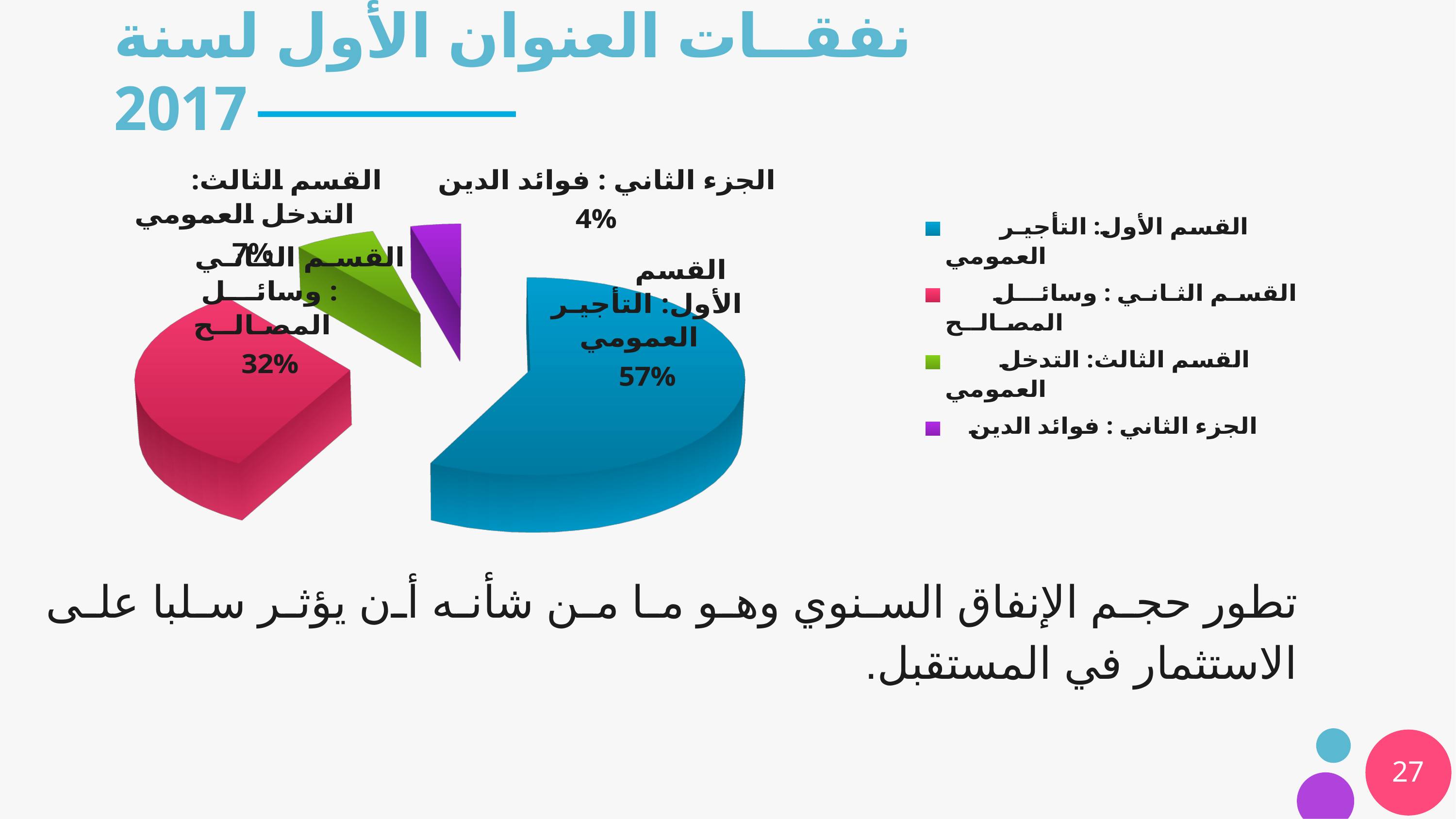
What share of the pie does القسم الثاني: وسائل المصالح represent? 32% Which category has the largest slice of the pie? القسم الأول: التأجير العمومي What kind of chart is shown on the slide? pie chart What share of the pie does القسم الثالث: التدخل العمومي represent? 7% Which is larger, the slice for القسم الثاني: وسائل المصالح or the slice for الجزء الثاني: فوائد الدين? القسم الثاني: وسائل المصالح How many slices does the pie chart have? 4 What share of the pie does القسم الأول: التأجير العمومي represent? 57% What colour is the slice for القسم الأول: التأجير العمومي? blue What share of the pie does الجزء الثاني: فوائد الدين represent? 4% How many entries does the legend list? 4 Which category has the smallest slice of the pie? الجزء الثاني: فوائد الدين What is the difference in percentage points between القسم الأول: التأجير العمومي and القسم الثاني: وسائل المصالح? 25